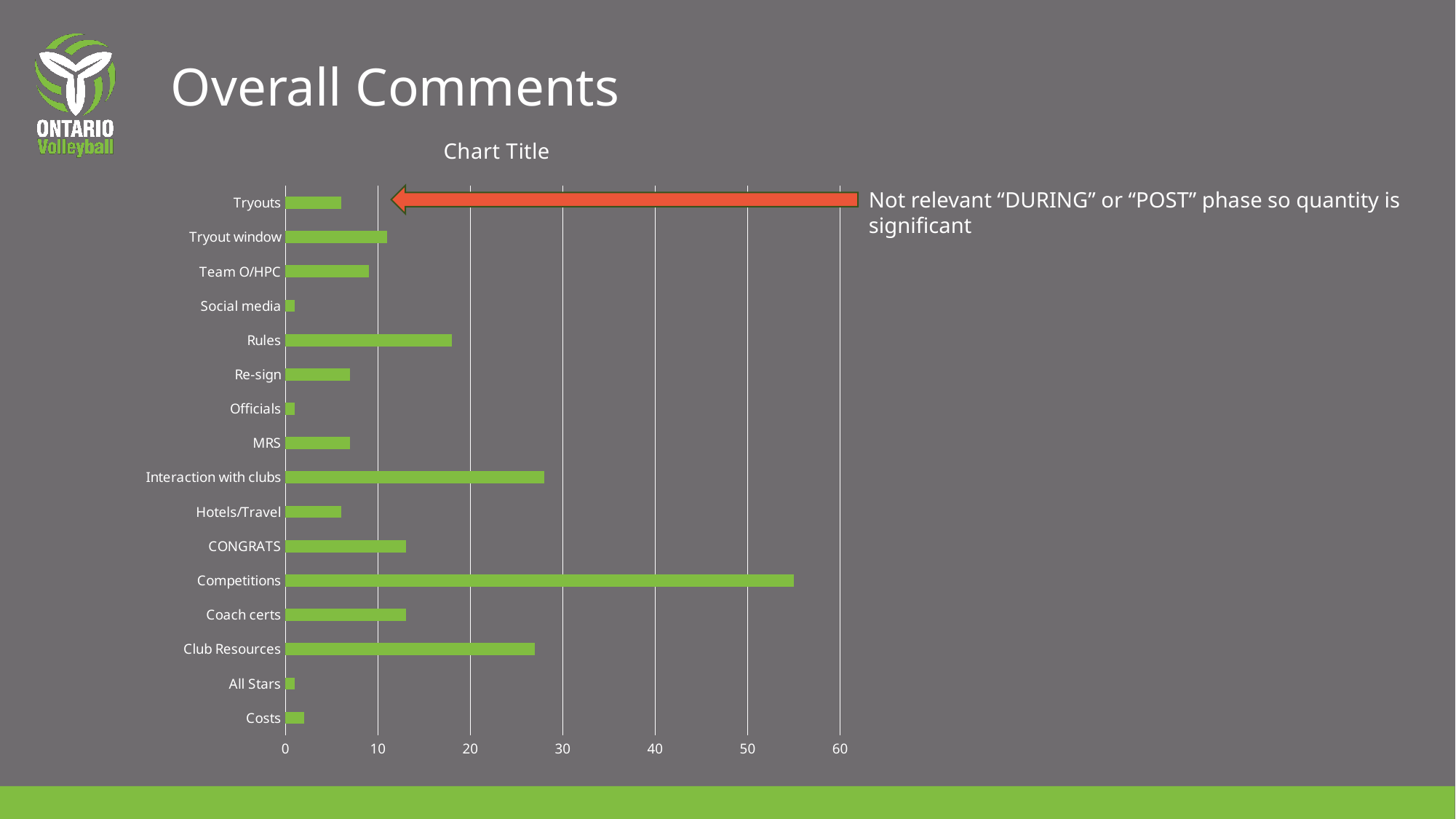
What kind of chart is shown on the slide? Bar chart How many categories are plotted in the chart? 16 Is the value for Interaction with clubs greater or less than 20? greater Is the value for Rules greater or less than 20? less Which category does the orange arrow on the slide point to? Tryouts Which has a larger value, Rules or Re-sign? Rules Which category has the highest value in the chart? Competitions Which has a larger value, Competitions or Interaction with clubs? Competitions Is the value for Competitions greater or less than 50? greater What is the title shown above the chart? Chart Title